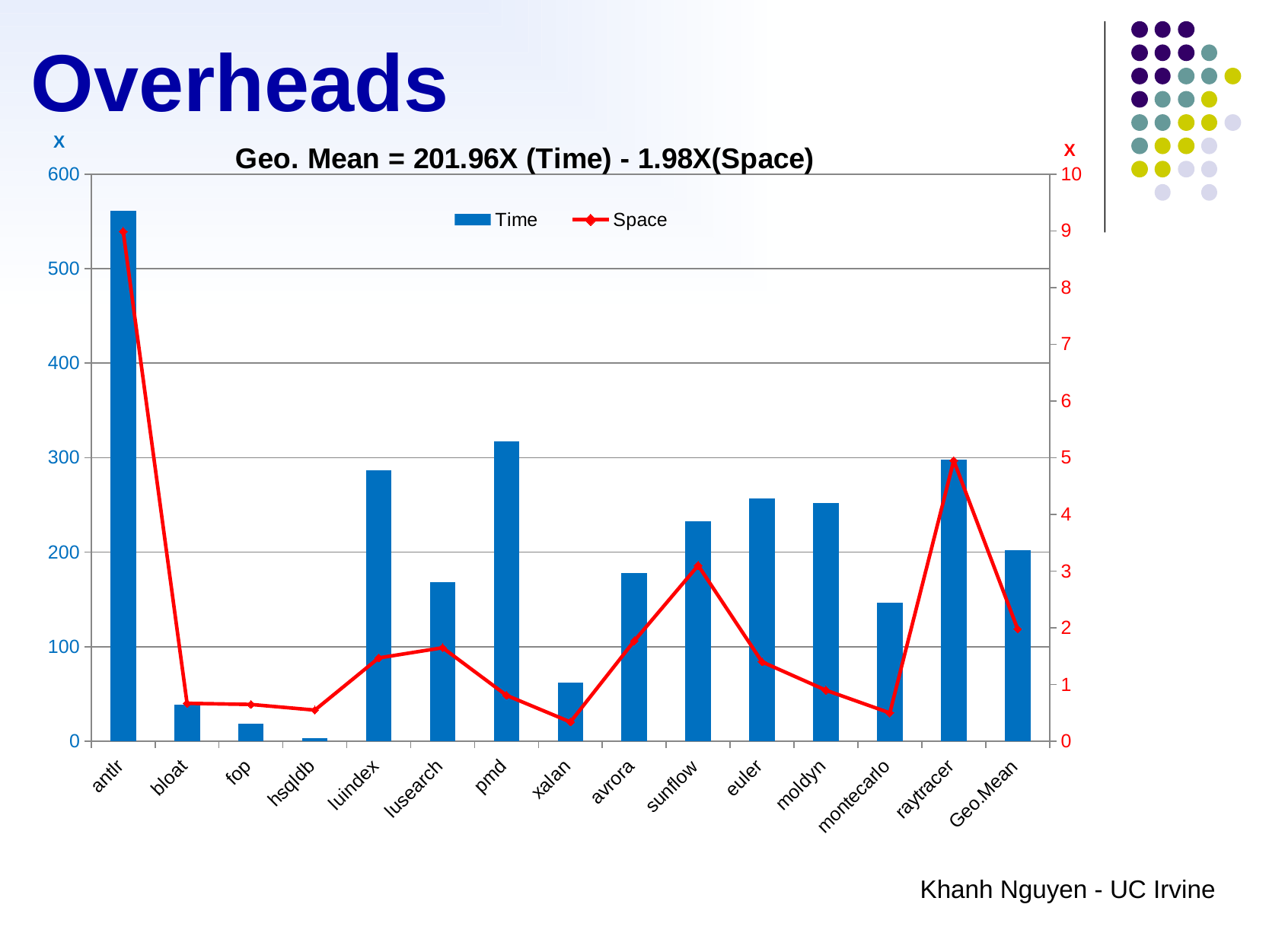
Which category has the highest Space value? antlr Which category has the lowest Time value? hsqldb Is the Time value for antlr greater or less than 500? greater Which has the larger Time value, pmd or luindex? pmd How many series does the legend list? 2 According to the chart title, what is the geometric mean of the Time overhead? 201.96X How many categories are shown along the x axis? 15 Is the Time value for xalan greater or less than 100? less Is the Time value for pmd greater or less than 300? greater Which category has the highest Time value? antlr What kind of chart is shown on the slide? A combined bar and line chart